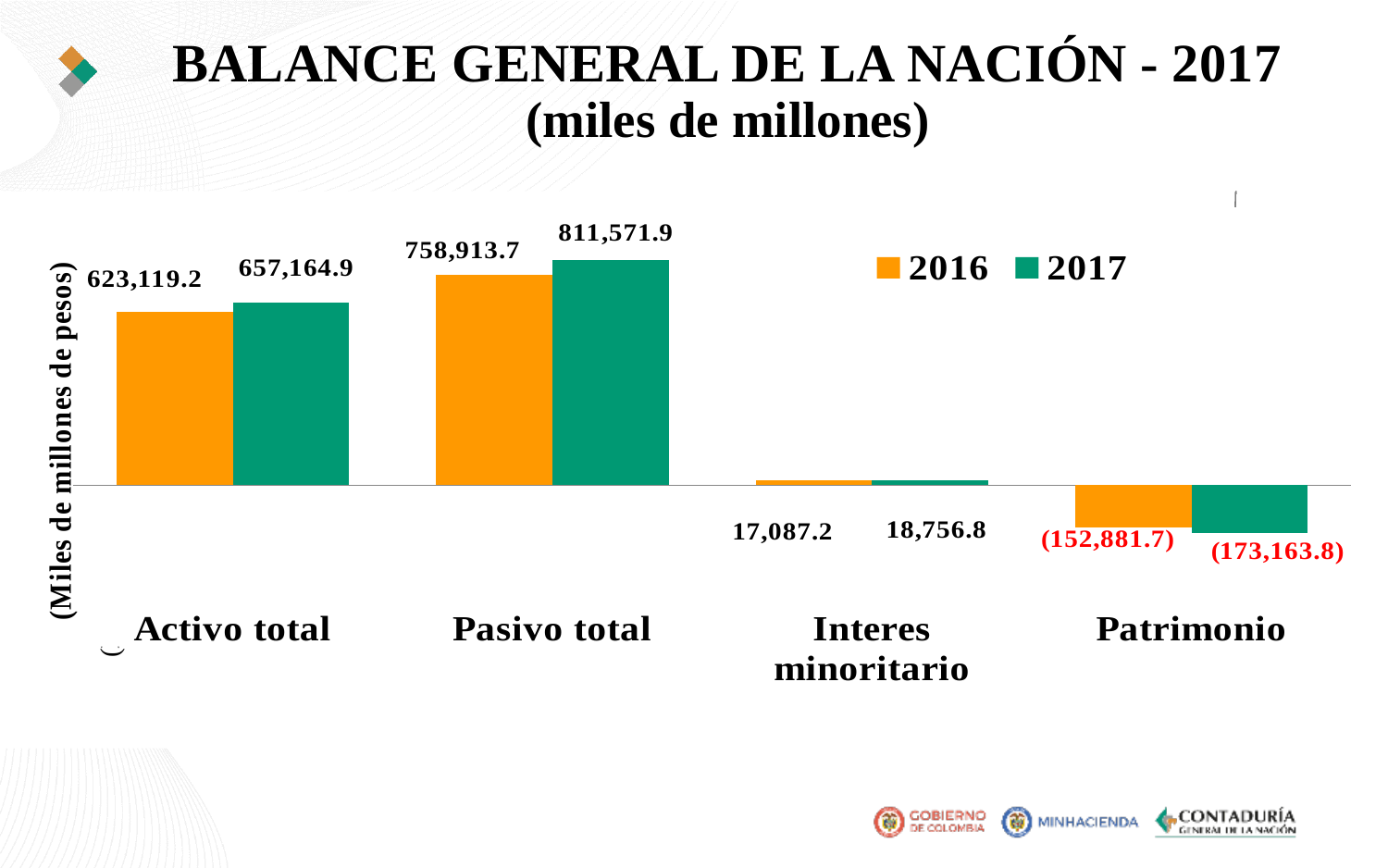
What kind of chart is shown on the slide? Bar chart How many categories are shown on the x axis? 4 Which category has the lowest value in 2016? Patrimonio What is the value for Pasivo total in 2017? 811,571.9 What is the difference between the 2017 and 2016 values for Pasivo total? 52,658.2 What is the value for Activo total in 2016? 623,119.2 Which category has the highest value in 2017? Pasivo total How many series does the legend list? 2 What is the difference between the 2017 and 2016 values for Activo total? 34,045.7 Which is larger, the 2016 or the 2017 value for Interes minoritario? 2017 What is the value for Patrimonio in 2017? (173,163.8) What is the value for Interes minoritario in 2016? 17,087.2